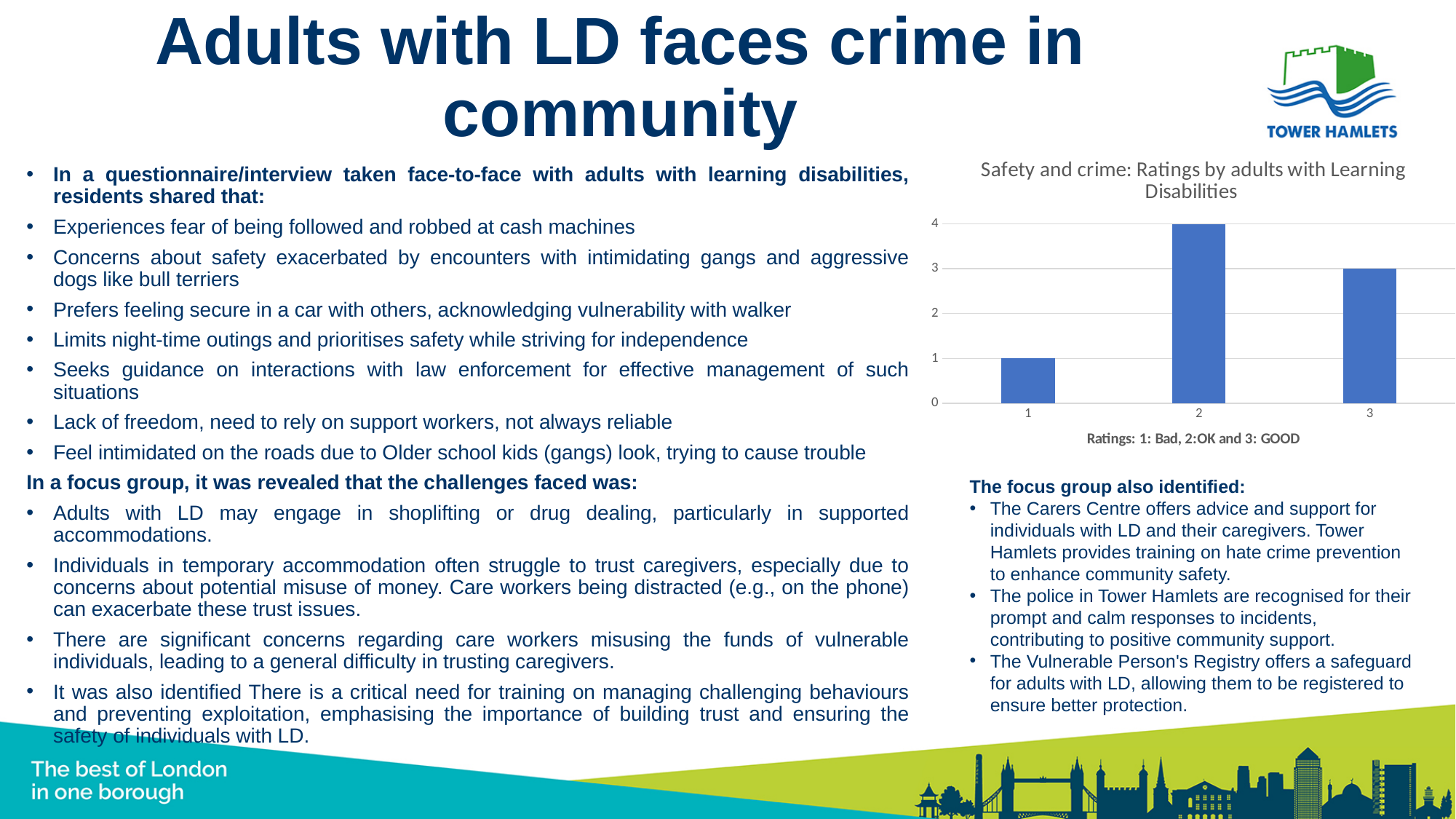
How many categories are shown on the x axis of the chart? 3 What is the difference between the values for rating 2 and rating 1? 3 Which is larger, the value for rating 3 or the value for rating 1? Rating 3 What type of chart is shown on the slide? Bar chart What is the value for rating 3 in the chart? 3 What is the value for rating 2 in the chart? 4 Which rating category has the highest value in the chart? 2 Which rating category has the lowest value in the chart? 1 Is the value for rating 2 greater or less than 3? greater What is the value for rating 1 in the chart? 1 What is the title of the chart? Safety and crime: Ratings by adults with Learning Disabilities What does the x-axis label say the ratings mean? Ratings: 1: Bad, 2:OK and 3: GOOD